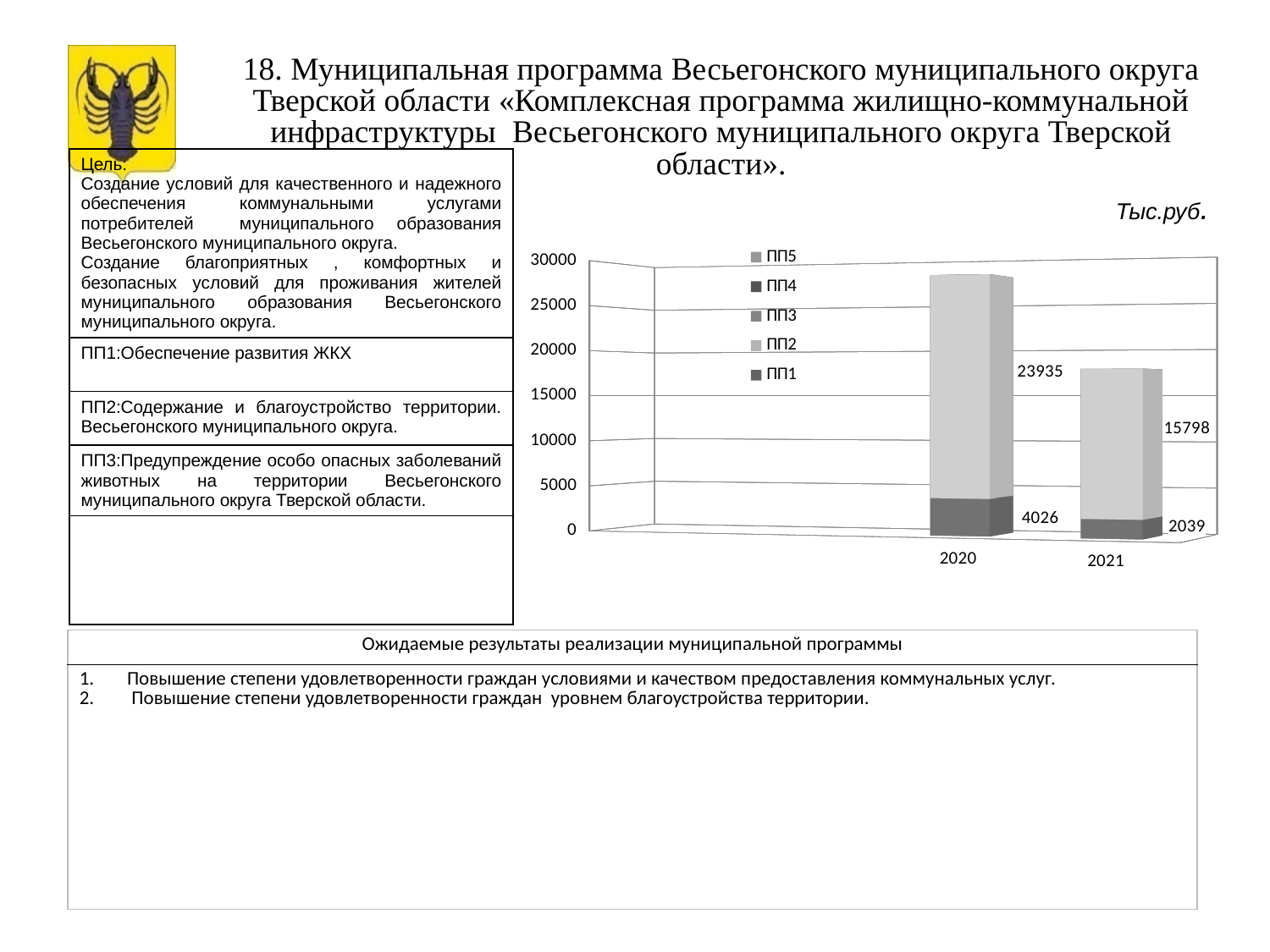
What is the value of the upper (light) segment of the 2020 bar? 23935 Which year has the taller stacked bar, 2020 or 2021? 2020 What is the difference between the upper segment values for 2020 (23935) and 2021 (15798)? 8137 How many series does the chart legend list? 5 How many categories (years) are shown on the x axis of the chart? 2 What is the value of the bottom (dark) segment of the 2021 bar? 2039 What unit is indicated above the chart? Тыс.руб. What is the total of the stacked bar for 2021? 17837 What is the value of the upper (light) segment of the 2021 bar? 15798 What is the value of the bottom (dark) segment of the 2020 bar? 4026 What kind of chart is shown on the slide? stacked bar chart What is the total of the stacked bar for 2020? 27961